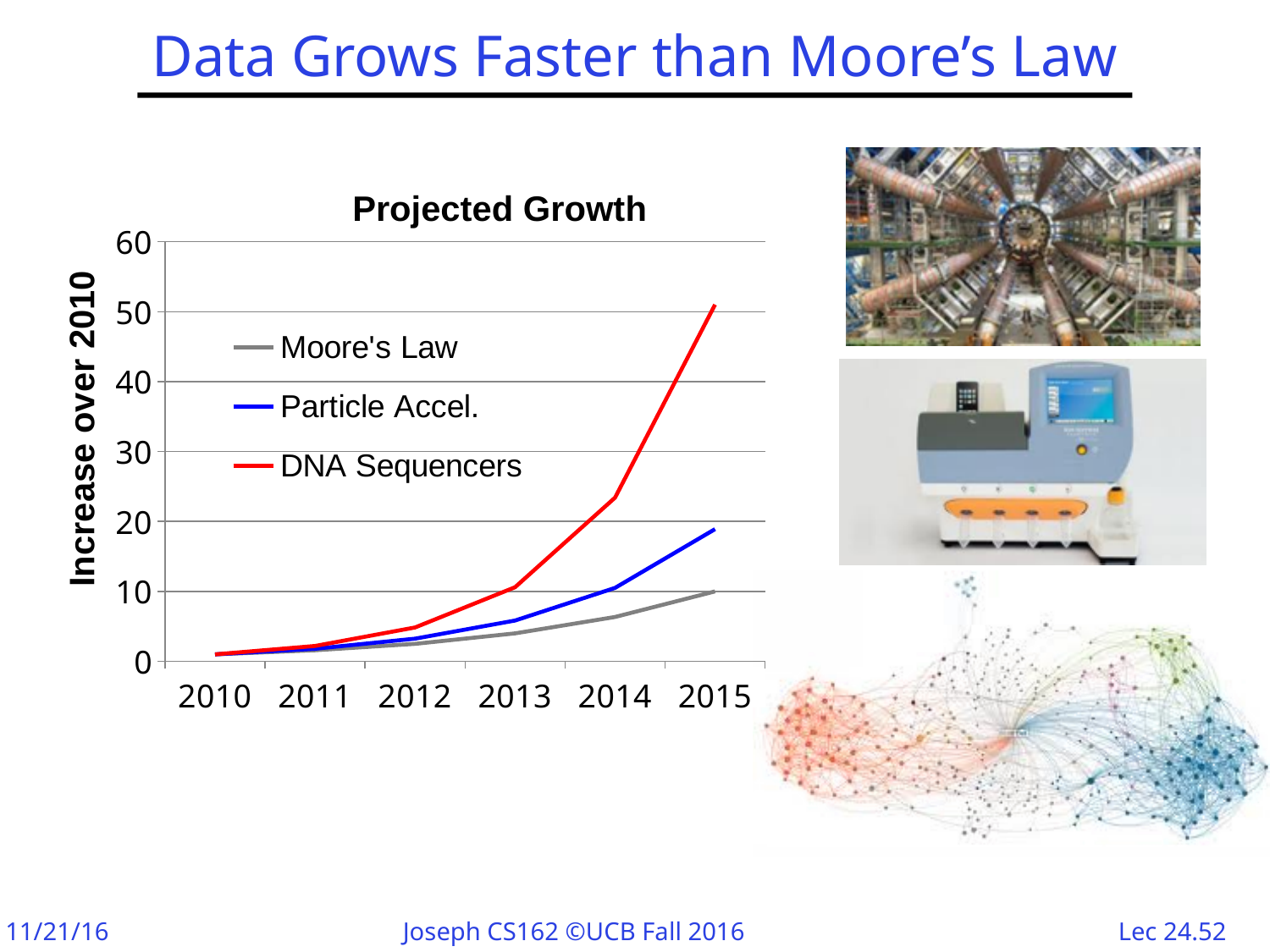
In 2015, which is larger in the "Projected Growth" chart: Particle Accel. or Moore's Law? Particle Accel. Which series has the lowest value in 2015 in the "Projected Growth" chart? Moore's Law What is the title of the chart on the slide? Projected Growth Does the DNA Sequencers line rise or fall from 2010 to 2015? rise What type of chart is shown under the title "Projected Growth"? line chart What is the y-axis label of the "Projected Growth" chart? Increase over 2010 How many years are shown on the x axis of the "Projected Growth" chart? 6 How many series does the legend of the "Projected Growth" chart list? 3 Is the value for DNA Sequencers in 2014 greater or less than 20? greater Which series has the highest value in 2015 in the "Projected Growth" chart? DNA Sequencers Is the value for Moore's Law in 2015 greater or less than 20? less Is the value for DNA Sequencers in 2015 greater or less than 40? greater